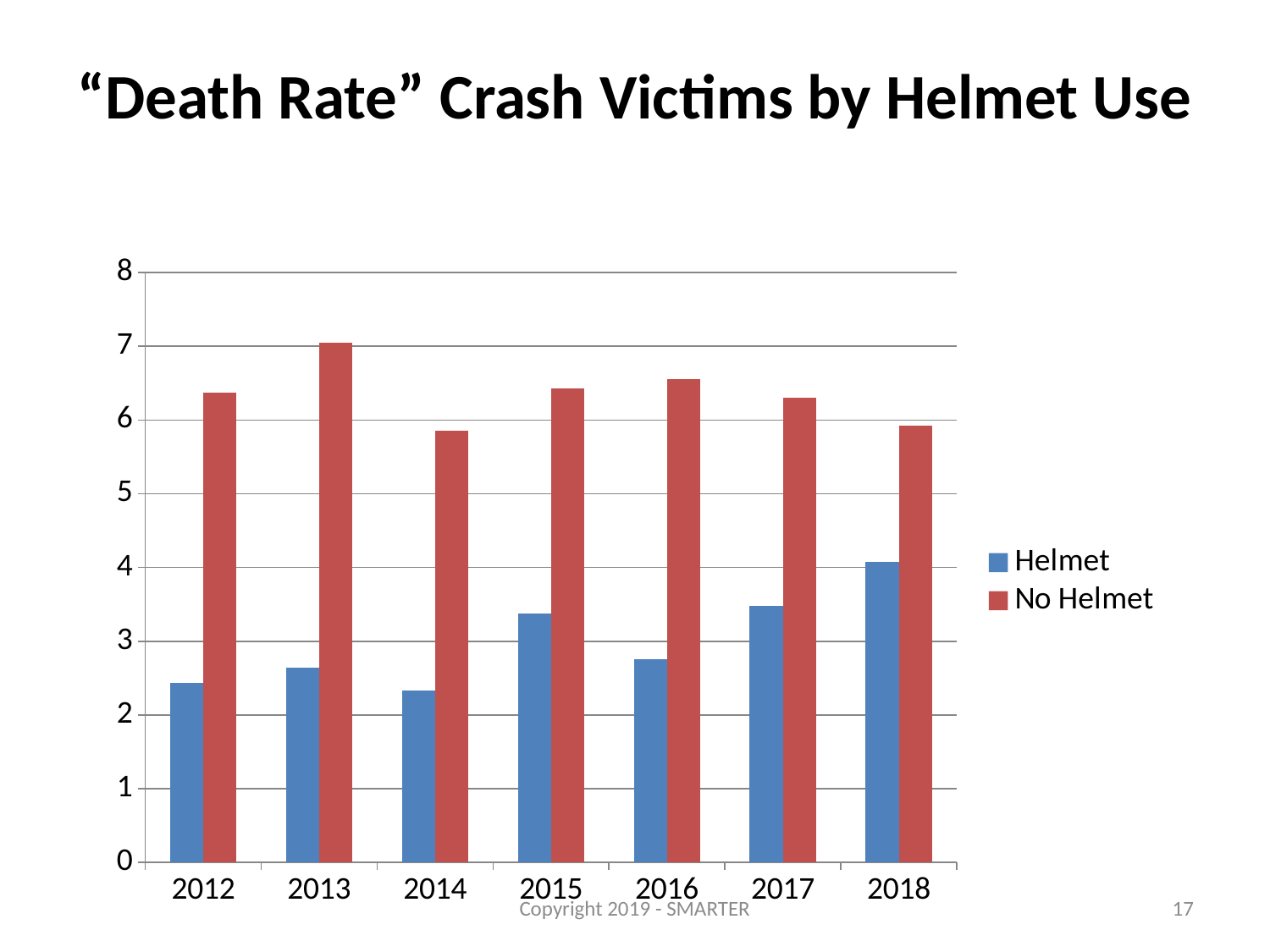
In which year is the No Helmet death rate highest? 2013 How many years are shown on the x axis? 7 How many series does the legend list? 2 In which year is the Helmet death rate highest? 2018 Is the Helmet value for 2012 greater or less than 3? less Which series is shown in red? No Helmet Is the Helmet value for 2015 greater or less than 3? greater Which is larger, the Helmet value for 2017 or the Helmet value for 2016? 2017 Which is larger, the No Helmet value for 2013 or the No Helmet value for 2014? 2013 Is the No Helmet value for 2014 greater or less than 6? less What kind of chart is shown on the slide? bar chart